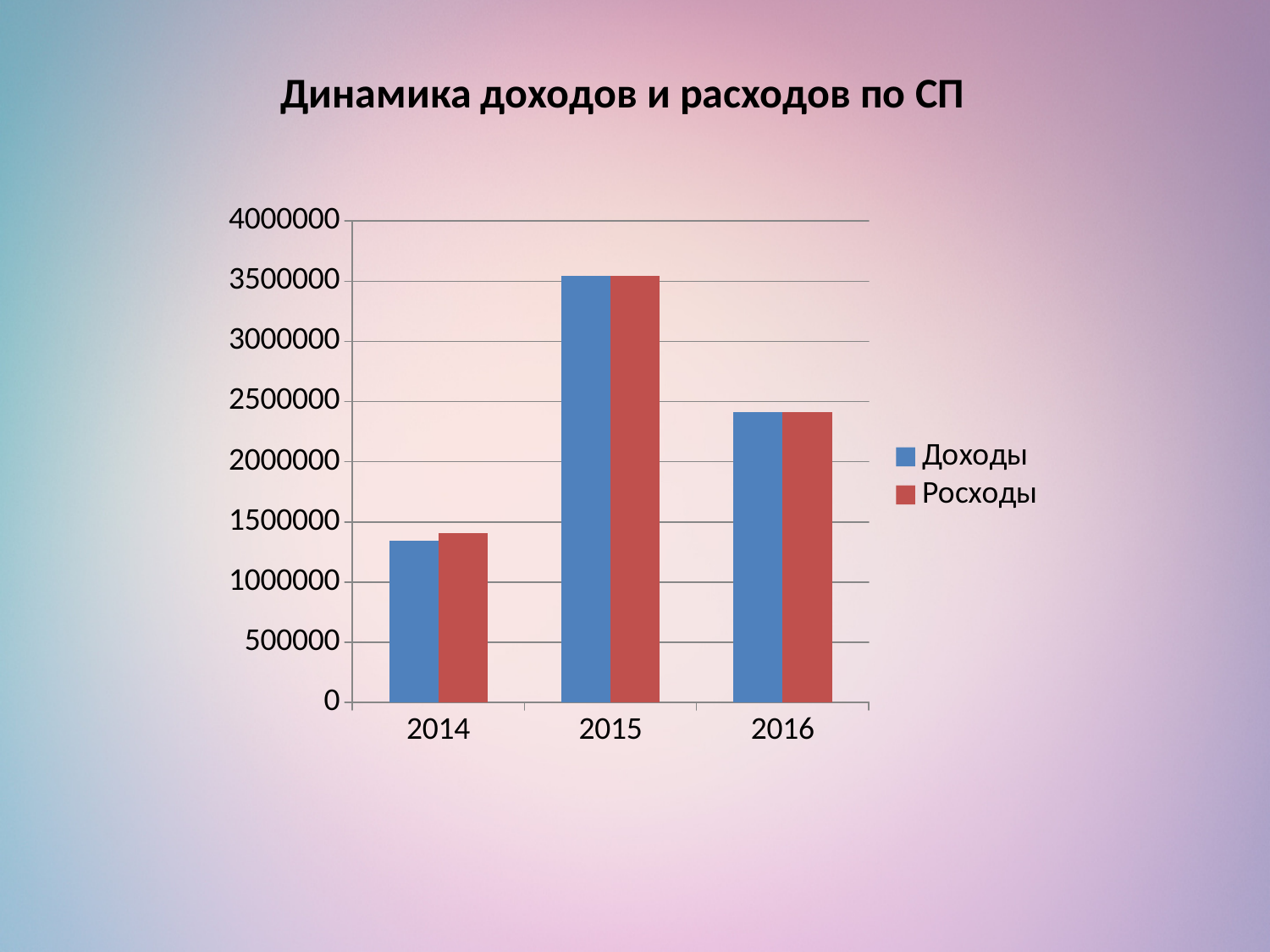
Is the value for Доходы in 2015 greater or less than 3000000? greater In which year is the value for Доходы highest? 2015 Which colour represents the series Доходы? blue Which is larger: Доходы in 2015 or Доходы in 2016? Доходы in 2015 In which year is the value for Росходы lowest? 2014 How many years are shown on the x axis? 3 How many series does the legend list? 2 What is the title of the chart? Динамика доходов и расходов по СП Is the value for Доходы in 2016 greater or less than 2500000? less Do the values for Росходы rise or fall from 2015 to 2016? fall What kind of chart is shown on the slide? bar chart Is the value for Росходы in 2014 greater or less than 1500000? less